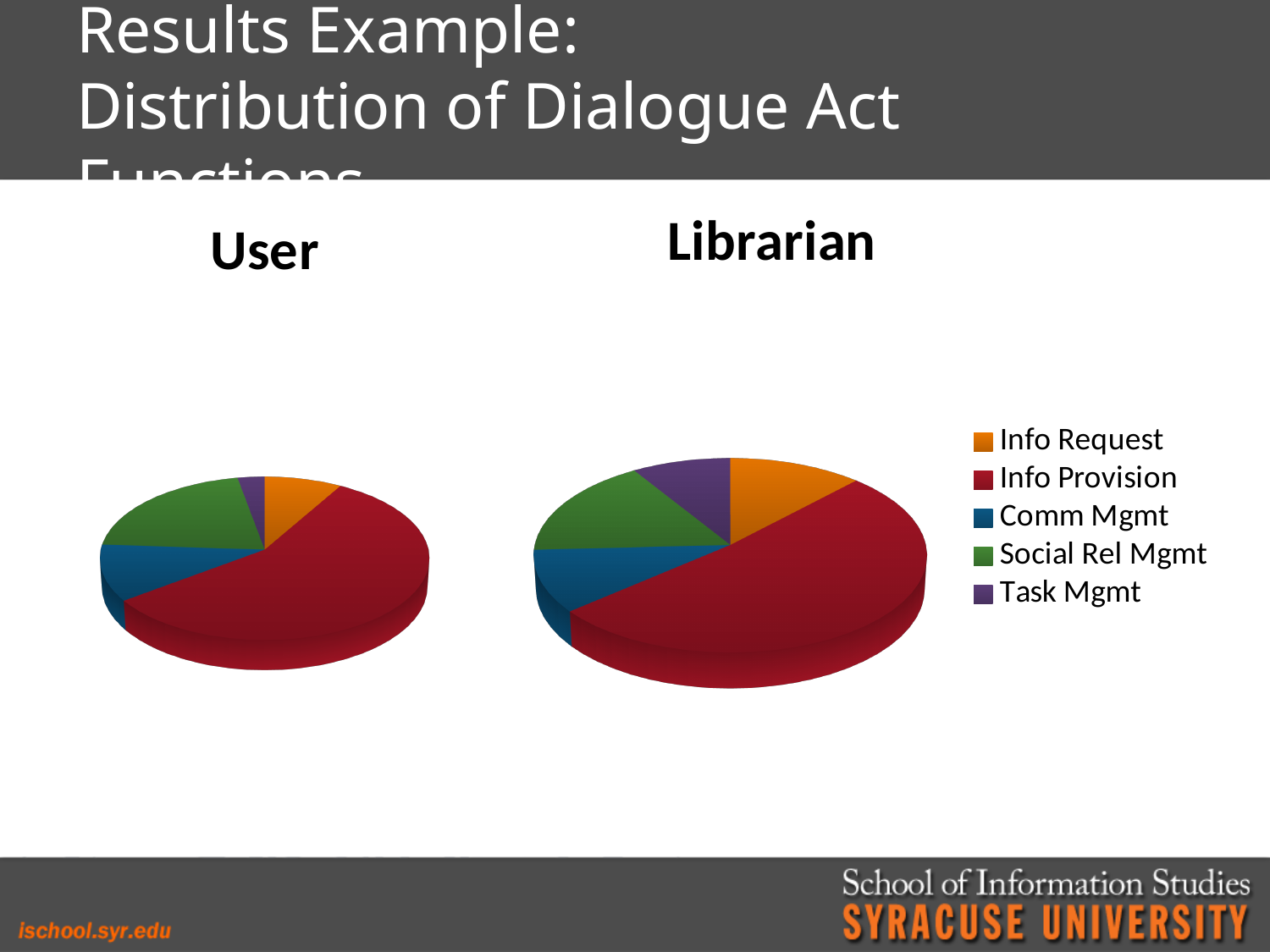
What kind of chart is the User chart? pie chart What kind of chart is the Librarian chart? pie chart In the Librarian chart, which category has the largest slice? Info Provision How many categories does the legend list for the pie charts? 5 In the User chart, which slice is larger: Social Rel Mgmt or Task Mgmt? Social Rel Mgmt What are the titles of the two pie charts on the slide? User and Librarian In the User chart, which category has the largest slice? Info Provision How many slices does the User pie chart have? 5 In the Librarian chart, which slice is larger: Info Provision or Comm Mgmt? Info Provision What colour represents Info Provision in the legend? red In the User chart, which category has the smallest slice? Task Mgmt In the User chart, which slice is larger: Info Provision or Social Rel Mgmt? Info Provision